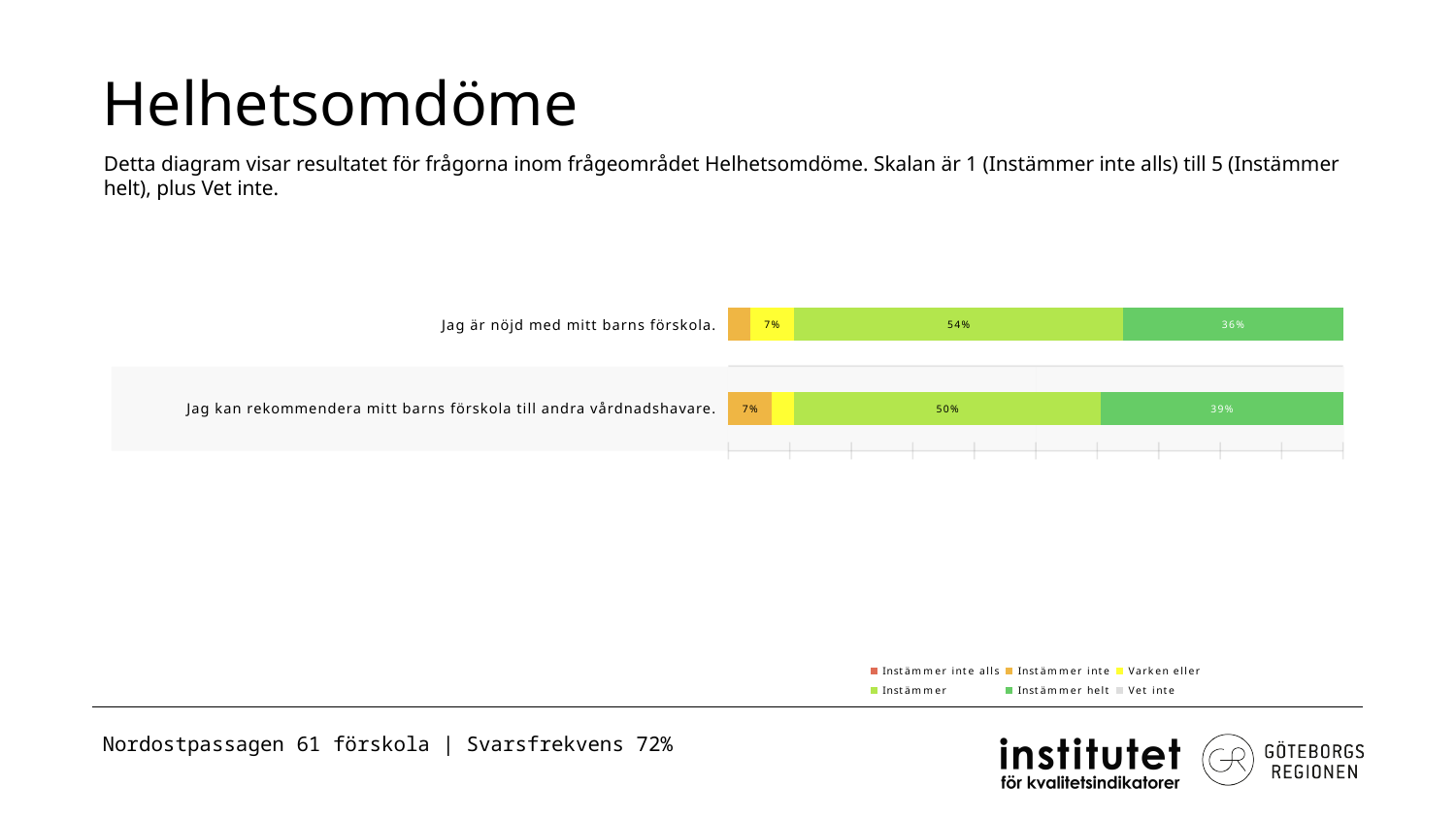
How many statements (bars) are shown in the chart? 2 What percentage of respondents answered "Instämmer helt" for "Jag är nöjd med mitt barns förskola."? 36% What percentage of respondents answered "Instämmer" for "Jag kan rekommendera mitt barns förskola till andra vårdnadshavare."? 50% Which statement has the larger "Instämmer helt" share? Jag kan rekommendera mitt barns förskola till andra vårdnadshavare. Which statement has the larger "Instämmer" share? Jag är nöjd med mitt barns förskola. What percentage of respondents answered "Varken eller" for "Jag är nöjd med mitt barns förskola."? 7% What is the difference in the "Instämmer" share between "Jag är nöjd med mitt barns förskola." and "Jag kan rekommendera mitt barns förskola till andra vårdnadshavare."? 4 percentage points What percentage of respondents answered "Instämmer helt" for "Jag kan rekommendera mitt barns förskola till andra vårdnadshavare."? 39% What type of chart is shown on the slide? Stacked bar chart Which response category has the largest share for "Jag är nöjd med mitt barns förskola."? Instämmer What percentage of respondents answered "Instämmer" for "Jag är nöjd med mitt barns förskola."? 54% How many response categories does the legend list? 6